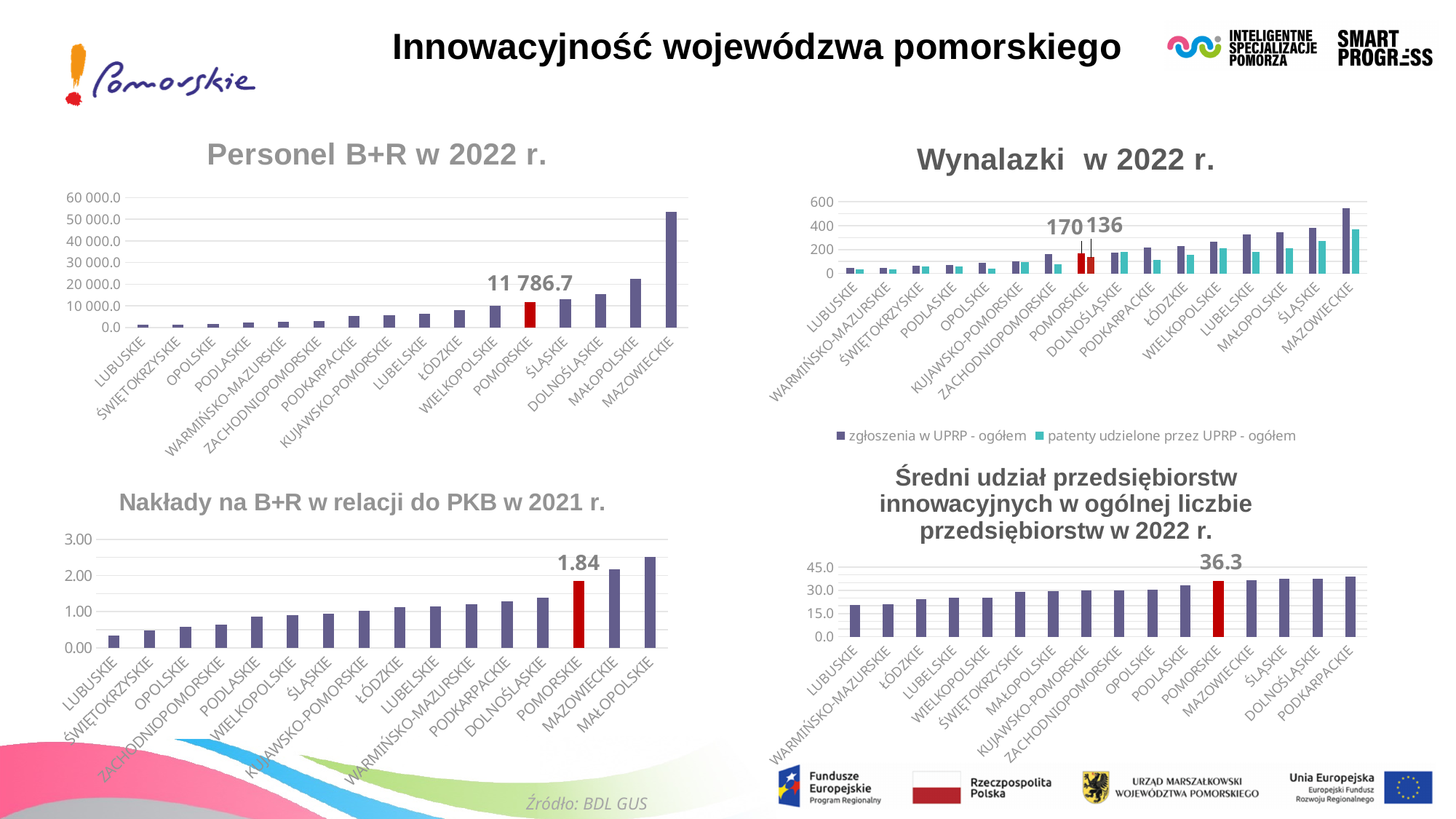
In the 'Personel B+R w 2022 r.' chart, what is the value for POMORSKIE? 11 786.7 How many series does the legend of the 'Wynalazki w 2022 r.' chart list? 2 In the 'Wynalazki w 2022 r.' chart, what is the value of 'patenty udzielone przez UPRP - ogółem' for POMORSKIE? 136 In the 'Wynalazki w 2022 r.' chart, what is the difference between the two labelled values for POMORSKIE? 34 In the 'Personel B+R w 2022 r.' chart, is the value for MAZOWIECKIE greater or less than 50 000.0? greater In the 'Średni udział przedsiębiorstw innowacyjnych w ogólnej liczbie przedsiębiorstw w 2022 r.' chart, what is the value for POMORSKIE? 36.3 In the 'Wynalazki w 2022 r.' chart, for MAZOWIECKIE, which series has the larger value: 'zgłoszenia w UPRP - ogółem' or 'patenty udzielone przez UPRP - ogółem'? zgłoszenia w UPRP - ogółem In the 'Personel B+R w 2022 r.' chart, which region has the highest value? MAZOWIECKIE In the 'Nakłady na B+R w relacji do PKB w 2021 r.' chart, what is the value for POMORSKIE? 1.84 In the 'Wynalazki w 2022 r.' chart, what is the value of 'zgłoszenia w UPRP - ogółem' for POMORSKIE? 170 In the 'Nakłady na B+R w relacji do PKB w 2021 r.' chart, which region has the highest value? MAŁOPOLSKIE In the 'Nakłady na B+R w relacji do PKB w 2021 r.' chart, which region has the lowest value? LUBUSKIE